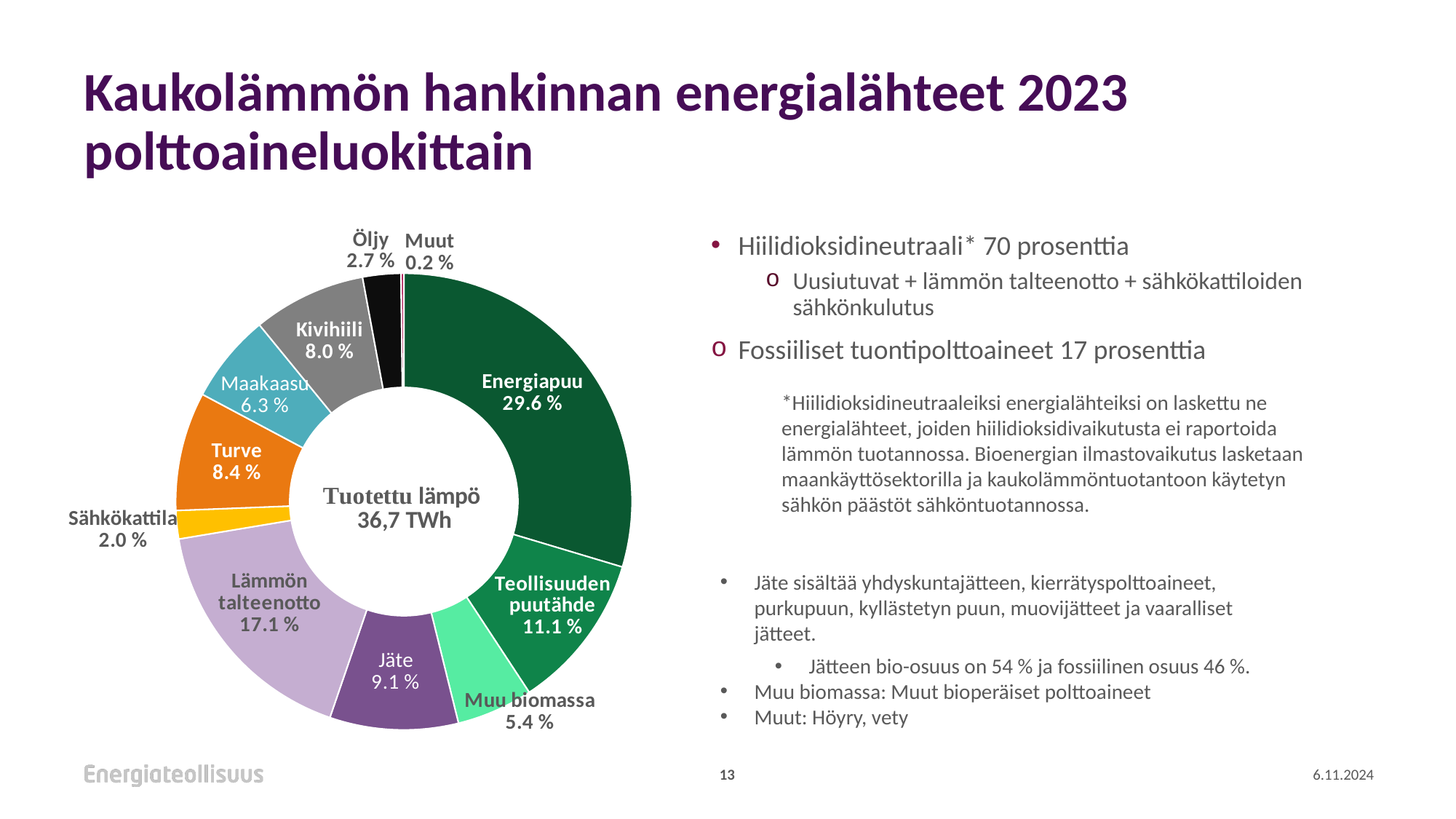
What is the combined share of Jäte and Muu biomassa? 14.5 % How many categories are shown in the chart? 11 What total amount of produced heat is shown in the centre of the chart? 36,7 TWh Which has a larger share, Turve or Maakaasu? Turve Which category has the smallest share in the chart? Muut What share does Kivihiili have in the chart? 8.0 % Which category has the largest share in the chart? Energiapuu What kind of chart is shown on the slide? Pie chart (donut) What share does Energiapuu have in the chart? 29.6 % What share does Lämmön talteenotto have in the chart? 17.1 % What share does Muut have in the chart? 0.2 % What is the difference in percentage points between Energiapuu and Teollisuuden puutähde? 18.5